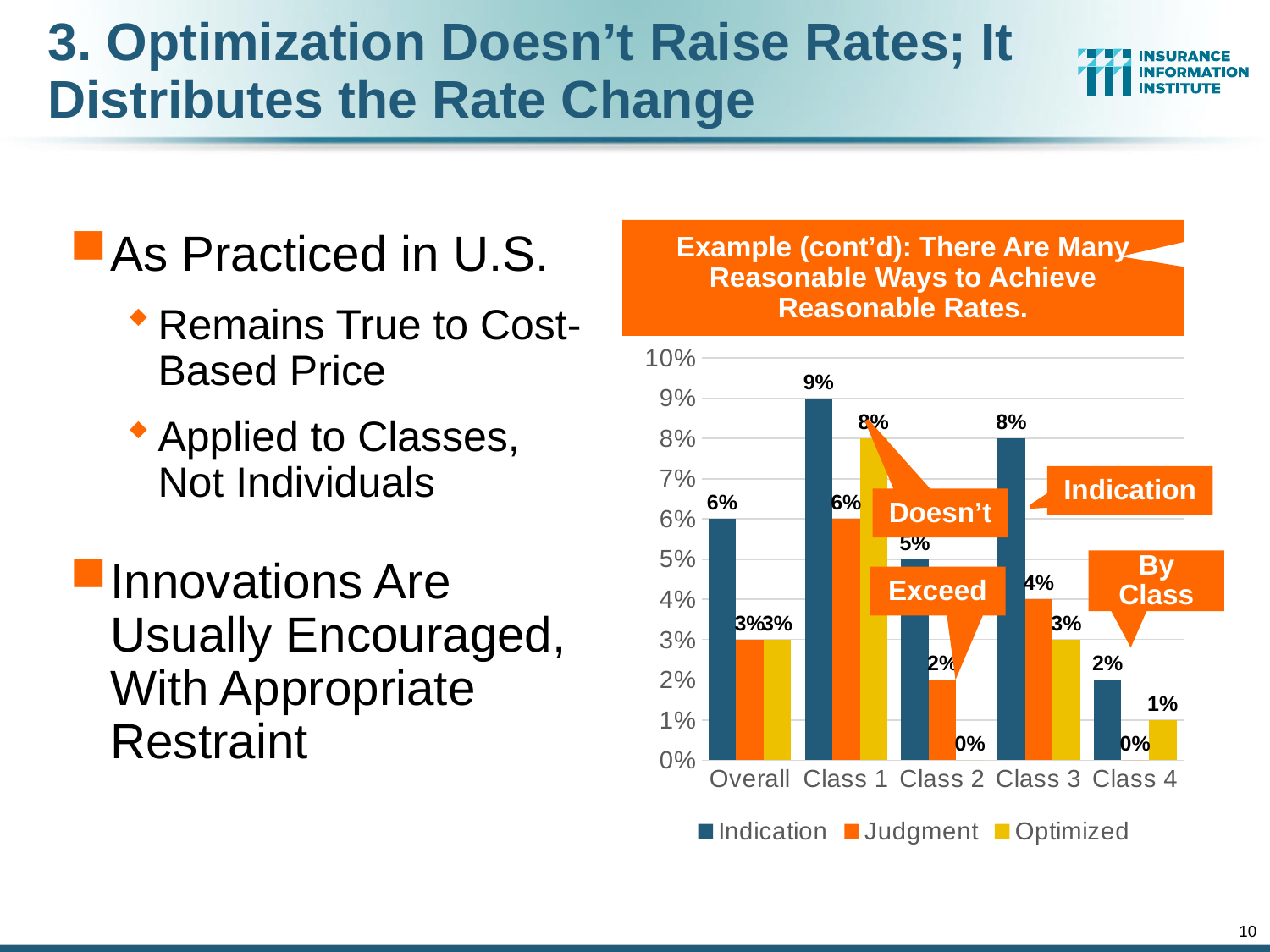
What is the Judgment value for Overall? 3% Which category has the lowest Indication value? Class 4 What is the Indication value for Class 1? 9% What is the title of the chart? Example (cont'd): There Are Many Reasonable Ways to Achieve Reasonable Rates. What is the Optimized value for Class 1? 8% What type of chart is shown on the slide? bar chart How many series does the chart legend list? 3 What is the difference between the Indication value and the Judgment value for Class 1? 3% How many categories are shown on the x axis of the chart? 5 Which category has the highest Indication value? Class 1 What is the Optimized value for Class 4? 1% Which is larger for Class 3, the Indication value or the Judgment value? Indication